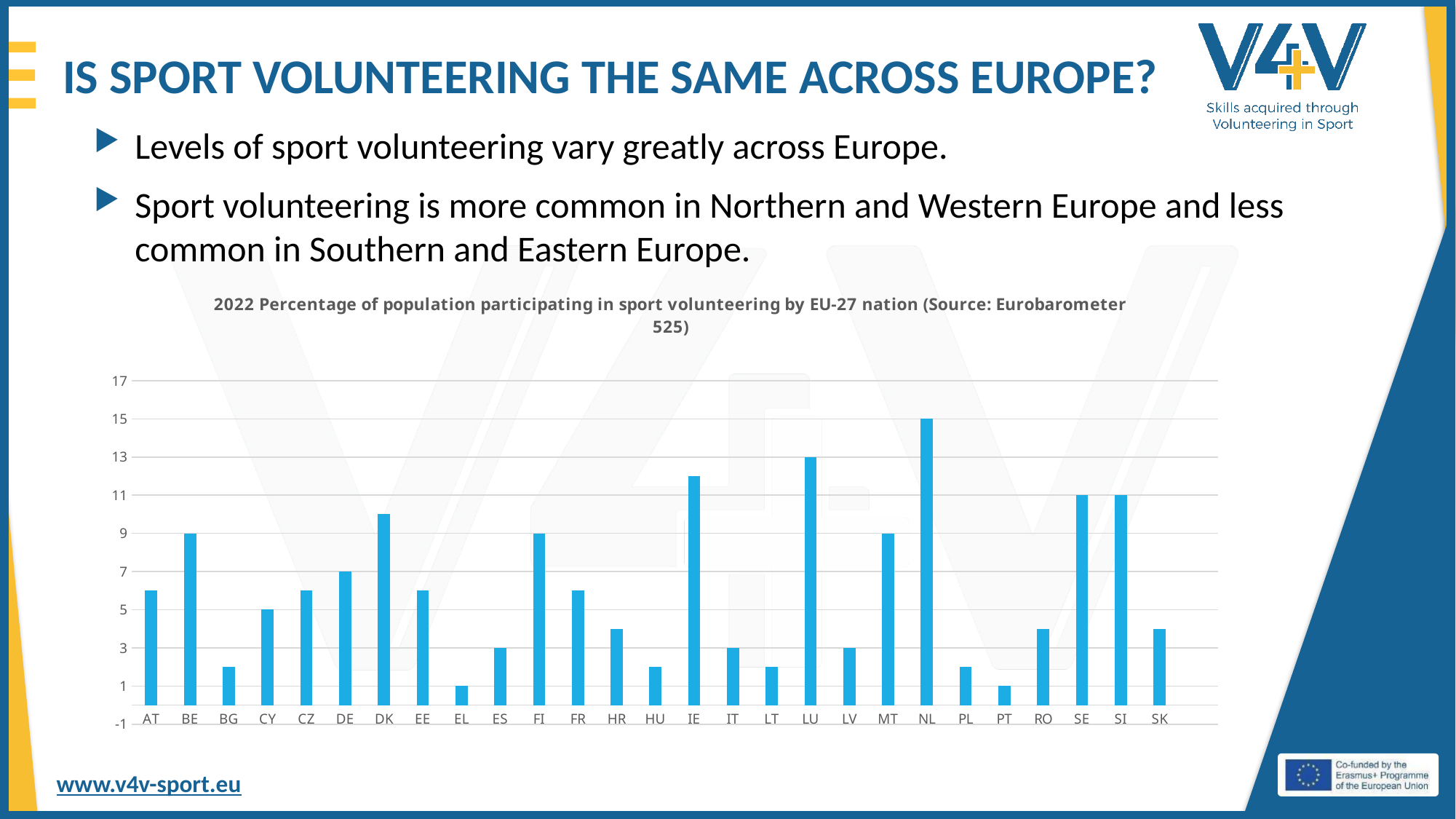
What is the value for LU? 13 What kind of chart is shown on the slide? bar chart What is the value for BE? 9 What is the value for NL? 15 What is the value for SE? 11 What is the difference between the values for NL and LU? 2 Which is larger, the value for IE or the value for DK? IE Is the value for HU greater or less than 3? less Which nation has the highest percentage of population participating in sport volunteering? NL Is the value for DK greater or less than 9? greater How many nations are shown on the x axis? 27 What is the source cited in the chart title? Eurobarometer 525